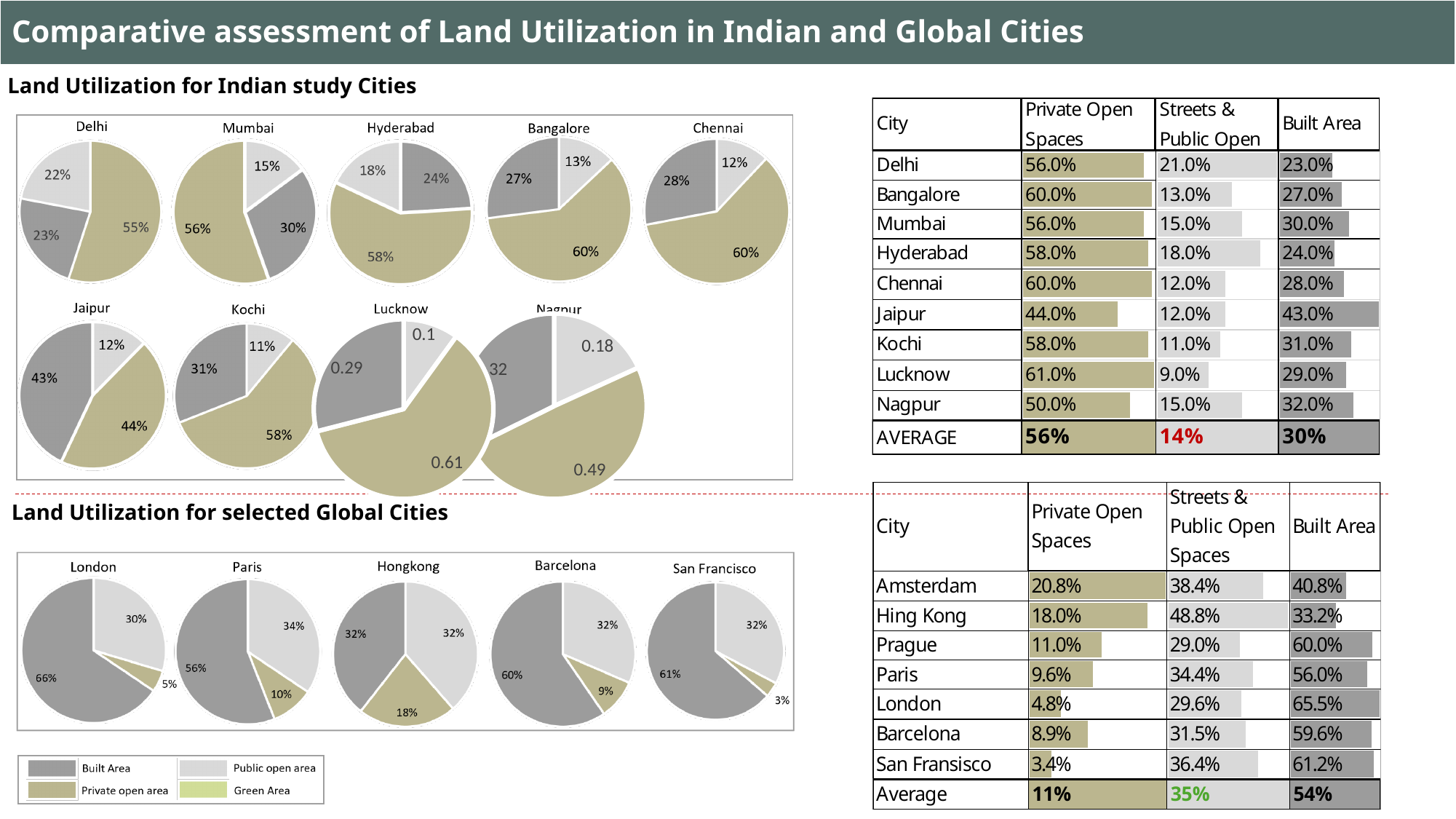
In the San Francisco pie chart, what percentage is shown for the private open area slice? 3% In the London pie chart, what percentage is shown for the built area slice? 66% In the Chennai pie chart, what is the difference between the private open area slice (60%) and the built area slice (28%)? 32% Which is larger in the Paris pie chart: the public open area slice or the private open area slice? Public open area (34%) What kind of chart is used to show land utilization for each city on the slide? Pie chart How many pie charts are shown in the 'Land Utilization for selected Global Cities' section? 5 In the Barcelona pie chart, which slice is the largest? Built area (60%) In the Jaipur pie chart, which slice is the smallest? Public open area (12%) How many entries does the legend at the bottom left of the slide list? 4 In the Delhi pie chart, what share is shown for the largest slice (private open area)? 55% In the Lucknow pie chart, what value is shown for the largest slice? 0.61 In the Mumbai pie chart, what percentage is shown for the built area slice? 30%